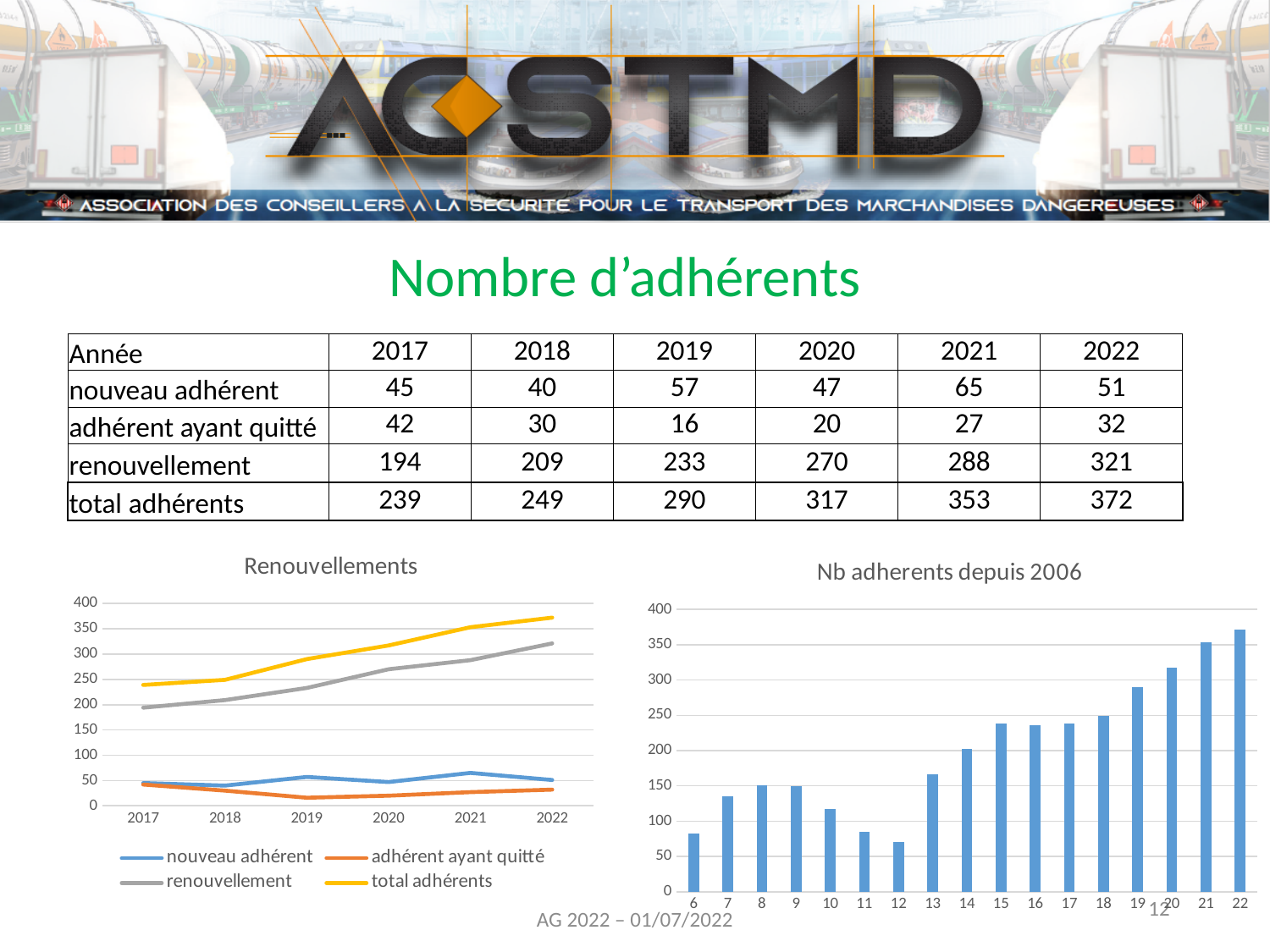
In the 'Nb adherents depuis 2006' chart, which year has the lowest bar? 12 In the 'Renouvellements' chart, which is larger in 2019: 'nouveau adhérent' or 'adhérent ayant quitté'? nouveau adhérent What kind of chart is the 'Renouvellements' chart? line chart What colour is the 'total adhérents' line in the 'Renouvellements' chart? yellow What kind of chart is the 'Nb adherents depuis 2006' chart? bar chart In the 'Nb adherents depuis 2006' chart, is the value for year 6 greater or less than 100? less How many years are shown on the x axis of the 'Renouvellements' chart? 6 In the 'Nb adherents depuis 2006' chart, which year has the highest bar? 22 In the 'Renouvellements' chart, does the 'total adhérents' line rise or fall from 2017 to 2022? rise In the 'Nb adherents depuis 2006' chart, is the value for year 15 greater or less than 200? greater How many bars are there in the 'Nb adherents depuis 2006' chart? 17 How many series does the legend of the 'Renouvellements' chart list? 4